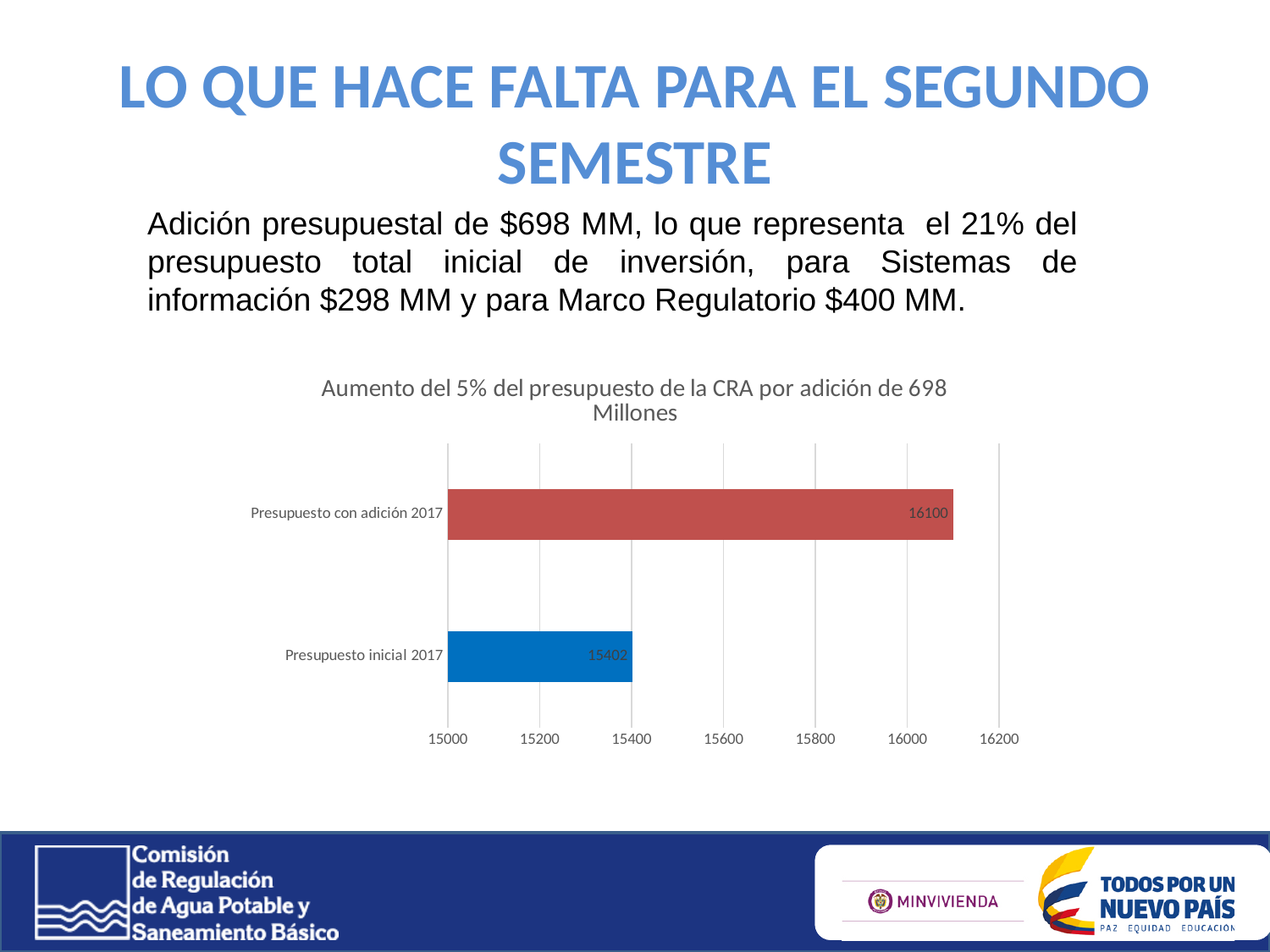
What colour is the bar for Presupuesto inicial 2017? blue Is the value for Presupuesto con adición 2017 greater or less than 16000? greater What is the difference between Presupuesto con adición 2017 and Presupuesto inicial 2017? 698 What is the value for Presupuesto con adición 2017? 16100 What is the value for Presupuesto inicial 2017? 15402 Which is larger, Presupuesto inicial 2017 or Presupuesto con adición 2017? Presupuesto con adición 2017 Which category has the lowest value? Presupuesto inicial 2017 What is the title of the chart? Aumento del 5% del presupuesto de la CRA por adición de 698 Millones How many categories are shown in the chart? 2 What kind of chart is shown on the slide? bar chart Is the value for Presupuesto inicial 2017 greater or less than 15600? less Which category has the highest value? Presupuesto con adición 2017